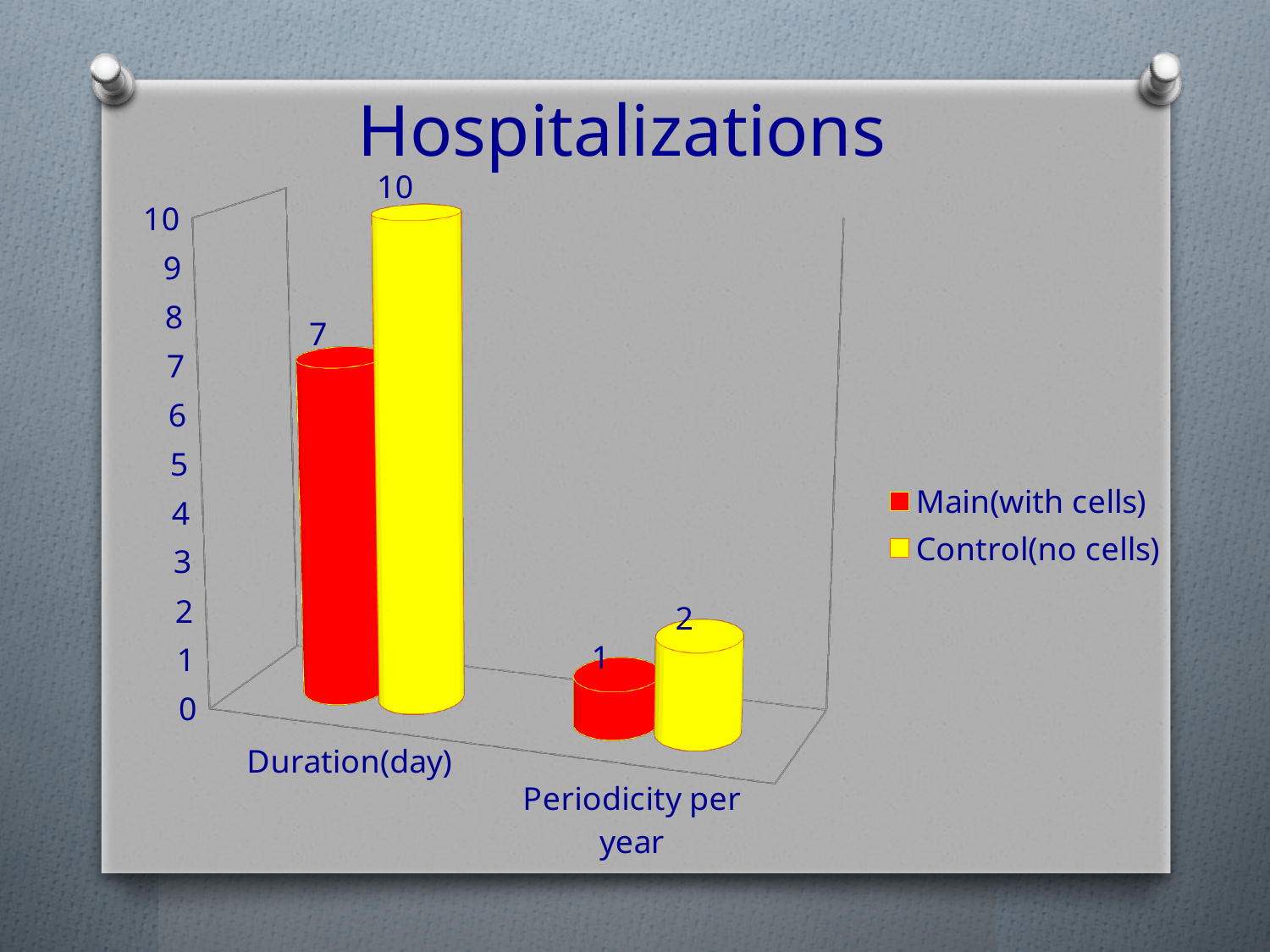
What is the difference between the Control(no cells) and Main(with cells) values for Periodicity per year? 1 Which series has the higher value for Duration(day)? Control(no cells) What is the value for Control(no cells) in the Periodicity per year category? 2 What is the title of the chart? Hospitalizations How many categories are shown on the x axis? 2 What is the difference between the Control(no cells) and Main(with cells) values for Duration(day)? 3 What is the value for Main(with cells) in the Duration(day) category? 7 How many series does the legend list? 2 Which series has the lower value for Periodicity per year? Main(with cells) What is the value for Main(with cells) in the Periodicity per year category? 1 What is the value for Control(no cells) in the Duration(day) category? 10 Is the Main(with cells) value for Duration(day) larger or smaller than the Control(no cells) value for Periodicity per year? larger